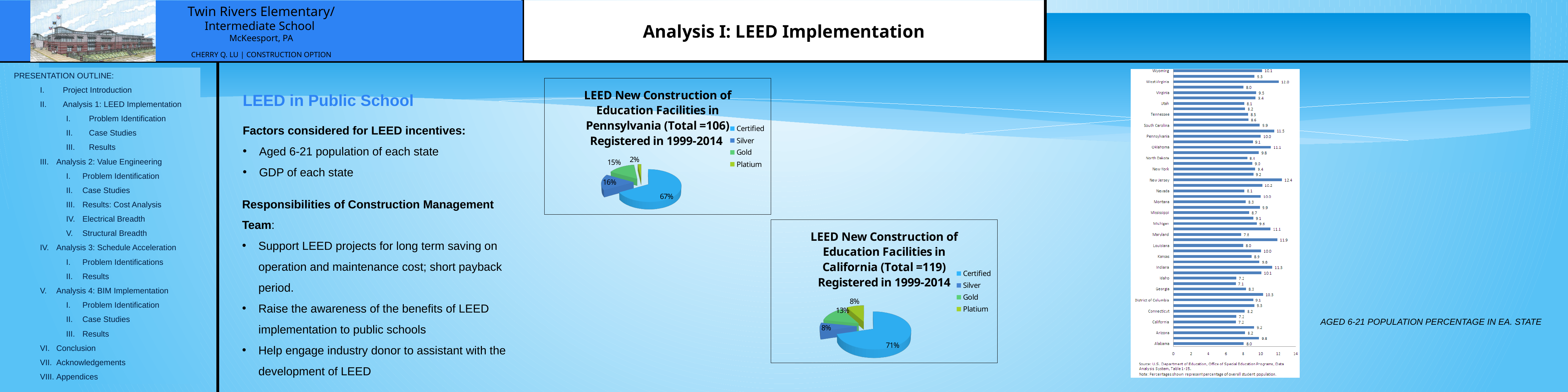
In the bar chart of aged 6-21 population percentage in each state, what is the value for Alabama? 8.0 In the pie chart titled 'LEED New Construction of Education Facilities in Pennsylvania', what percentage is Silver? 16% In the pie chart titled 'LEED New Construction of Education Facilities in Pennsylvania', what percentage is Certified? 67% Which is larger: the Certified share in the Pennsylvania pie chart or the Certified share in the California pie chart? California What kind of chart is the chart on the right side of the slide showing aged 6-21 population percentage in each state? Bar chart In the California pie chart, what percentage is Gold? 13% How many entries does the legend of the California pie chart list? 4 In the pie chart titled 'LEED New Construction of Education Facilities in California', what percentage is Certified? 71% In the California pie chart, which certification level has the largest share? Certified In the Pennsylvania pie chart, which certification level has the smallest share? Platium In the bar chart of aged 6-21 population percentage in each state, what is the value for Wyoming? 10.1 In the Pennsylvania pie chart, what is the difference between the Certified share and the Gold share? 52%